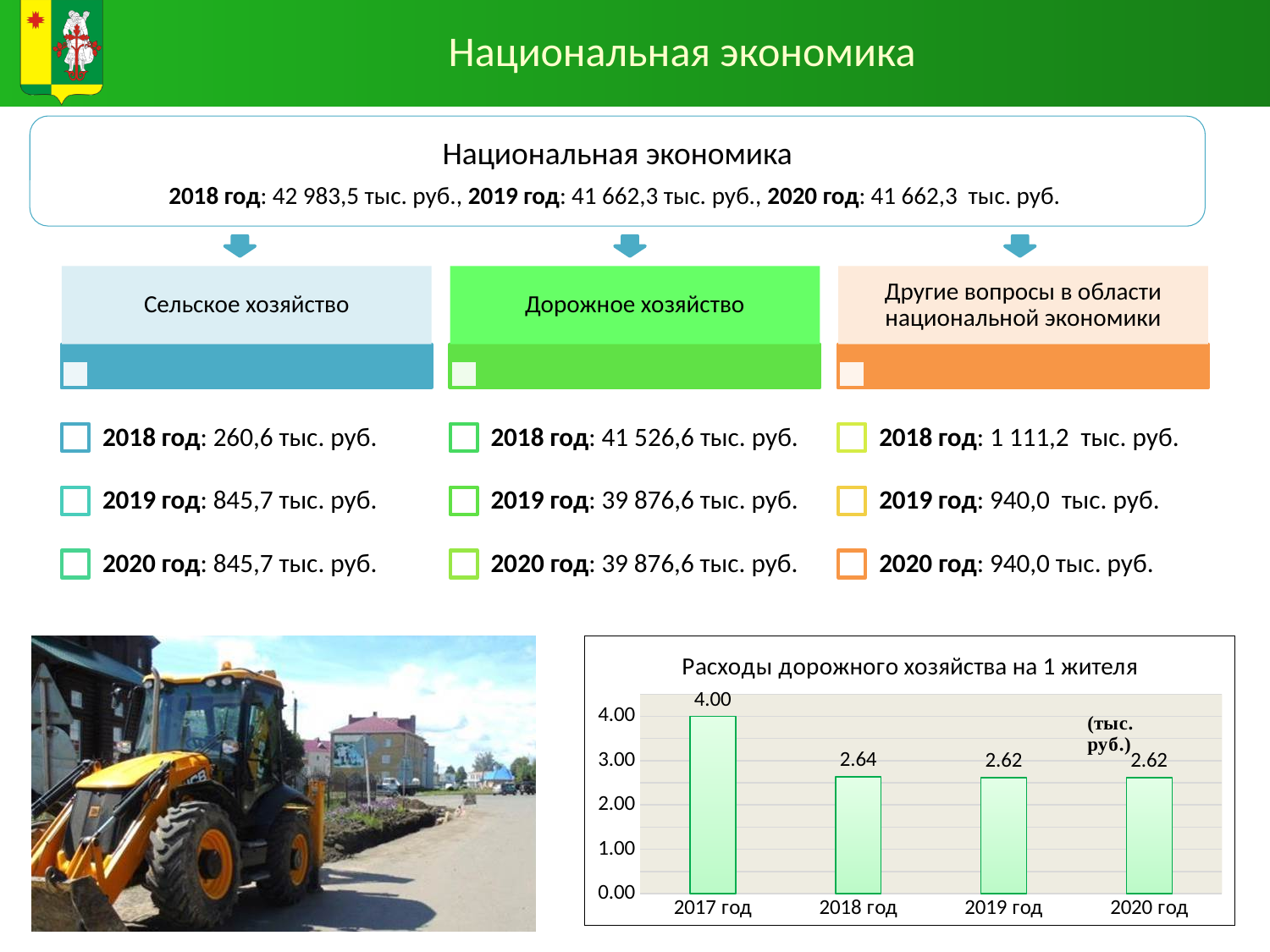
What is the value for 2018 год in the chart 'Расходы дорожного хозяйства на 1 жителя'? 2.64 What is the value for 2017 год in the chart 'Расходы дорожного хозяйства на 1 жителя'? 4.00 What is the value for 2020 год in the chart 'Расходы дорожного хозяйства на 1 жителя'? 2.62 What unit is indicated on the chart 'Расходы дорожного хозяйства на 1 жителя'? тыс. руб. Do the values in the chart 'Расходы дорожного хозяйства на 1 жителя' rise or fall from 2017 год to 2018 год? fall Is the value for 2018 год in the chart 'Расходы дорожного хозяйства на 1 жителя' greater or less than 3.00? less Which year has the highest value in the chart 'Расходы дорожного хозяйства на 1 жителя'? 2017 год In the chart 'Расходы дорожного хозяйства на 1 жителя', which is larger: the value for 2017 год or the value for 2019 год? 2017 год What is the difference between the values for 2018 год and 2019 год in the chart 'Расходы дорожного хозяйства на 1 жителя'? 0.02 What kind of chart is 'Расходы дорожного хозяйства на 1 жителя'? bar chart How many years are shown on the x axis of the chart 'Расходы дорожного хозяйства на 1 жителя'? 4 What is the difference between the values for 2017 год and 2018 год in the chart 'Расходы дорожного хозяйства на 1 жителя'? 1.36